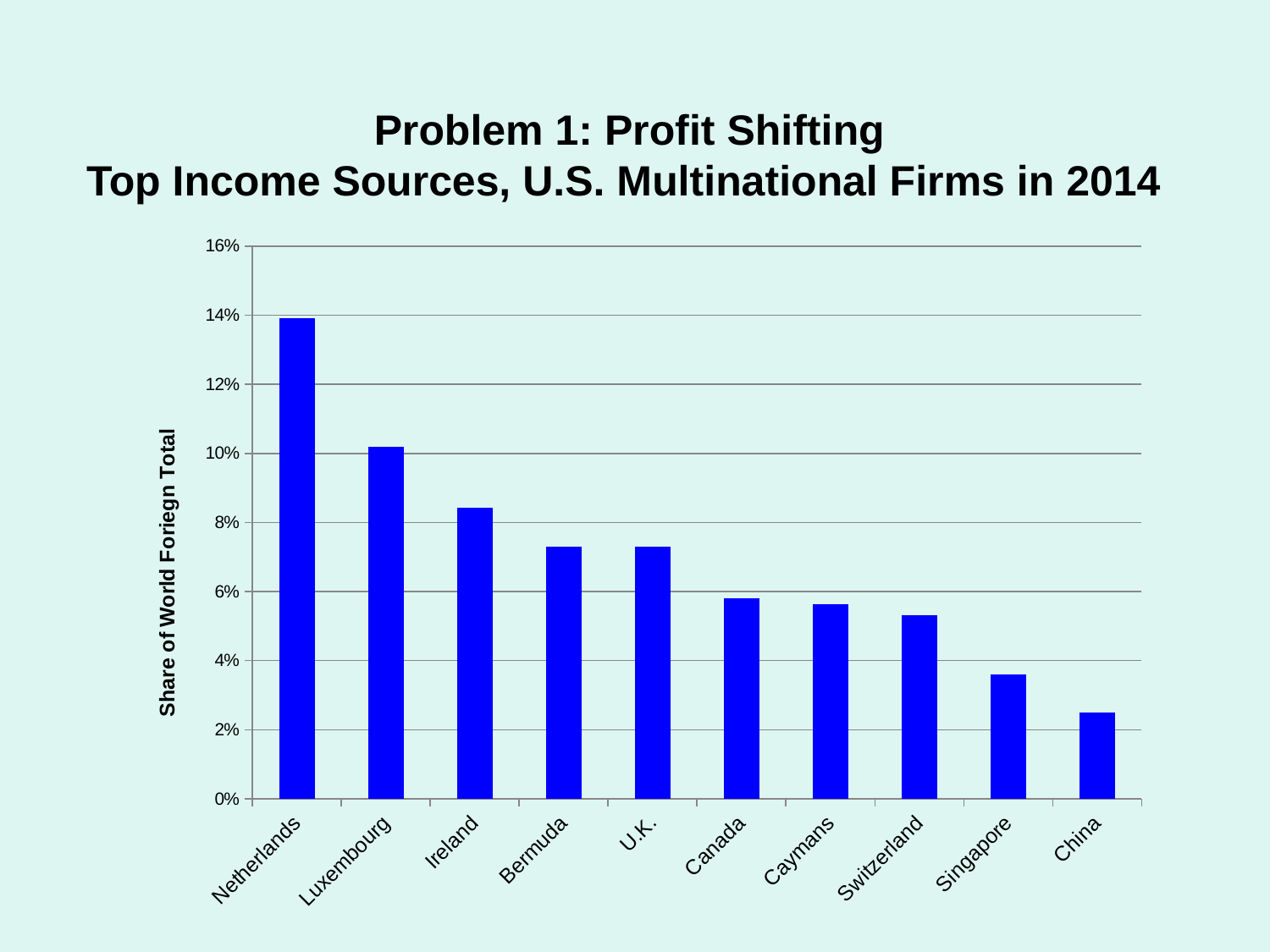
Is the value for Singapore greater or less than 4%? less Do the bar values rise or fall moving from left to right along the x axis? fall What kind of chart is shown on the slide? bar chart Which country has the lowest share of world foreign total? China Is the value for Switzerland greater or less than 4%? greater Is the value for China greater or less than 2%? greater Which has a larger share, Luxembourg or Ireland? Luxembourg How many countries are shown on the x axis of the chart? 10 What is the label on the vertical axis of the chart? Share of World Foriegn Total Which country has the highest share of world foreign total? Netherlands